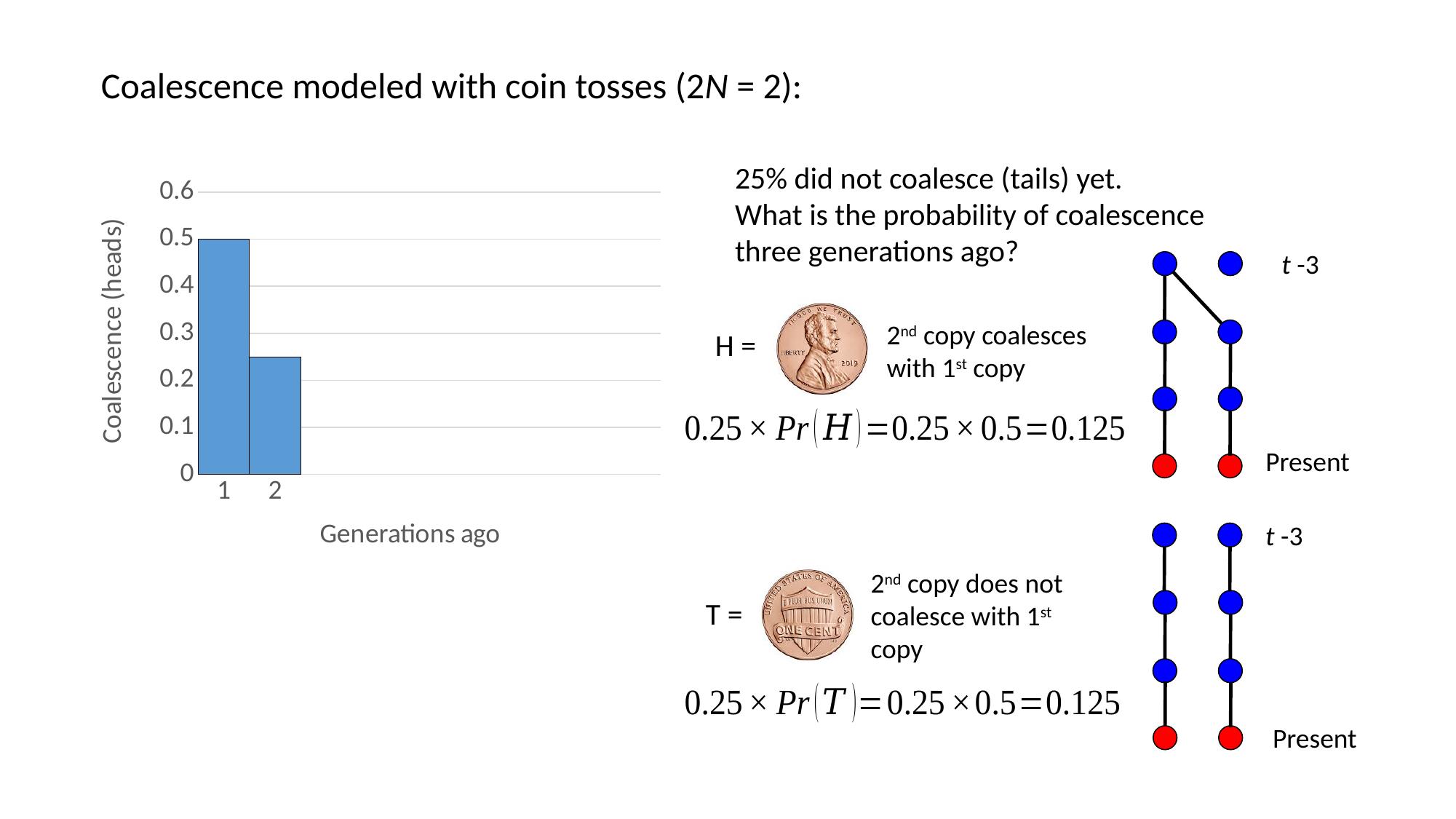
Is the value for generation 1 greater or less than 0.4? greater Is the value for generation 2 greater or less than 0.3? less What kind of chart is shown on the slide? bar chart What is the label of the x axis of the chart? Generations ago Which is larger, the value for generation 1 or generation 2? generation 1 What is the value of Coalescence (heads) for generation 1? 0.5 Do the values rise or fall as Generations ago increases from 1 to 2? fall Is the value for generation 2 greater or less than 0.2? greater How many bars are plotted in the chart? 2 Which generation has the lowest Coalescence (heads) value? 2 What is the label of the y axis of the chart? Coalescence (heads) Which generation has the highest Coalescence (heads) value? 1